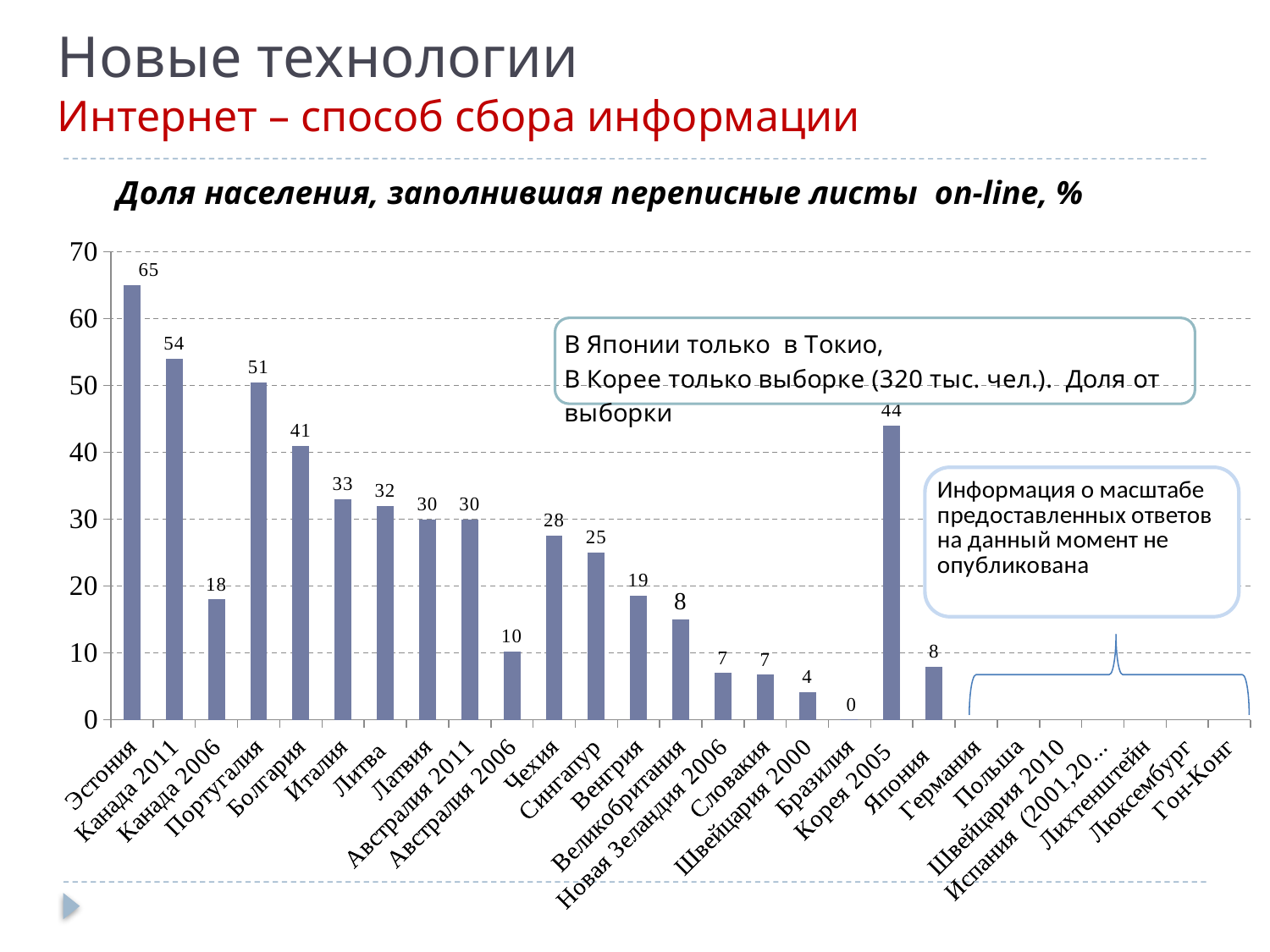
Which category has the highest value? Эстония What kind of chart is shown on the slide? bar chart Which is larger, the value for Япония or the value for Корея 2005? Корея 2005 What is the value for Корея 2005? 44 What is the difference between the values for Австралия 2011 and Австралия 2006? 20 Which is larger, the value for Португалия or the value for Болгария? Португалия What is the difference between the values for Канада 2011 and Канада 2006? 36 What is the value for Сингапур? 25 What is the title of the chart? Доля населения, заполнившая переписные листы on-line, % Is the value for Чехия greater or less than 20? greater What is the value for Бразилия? 0 What is the value for Эстония? 65